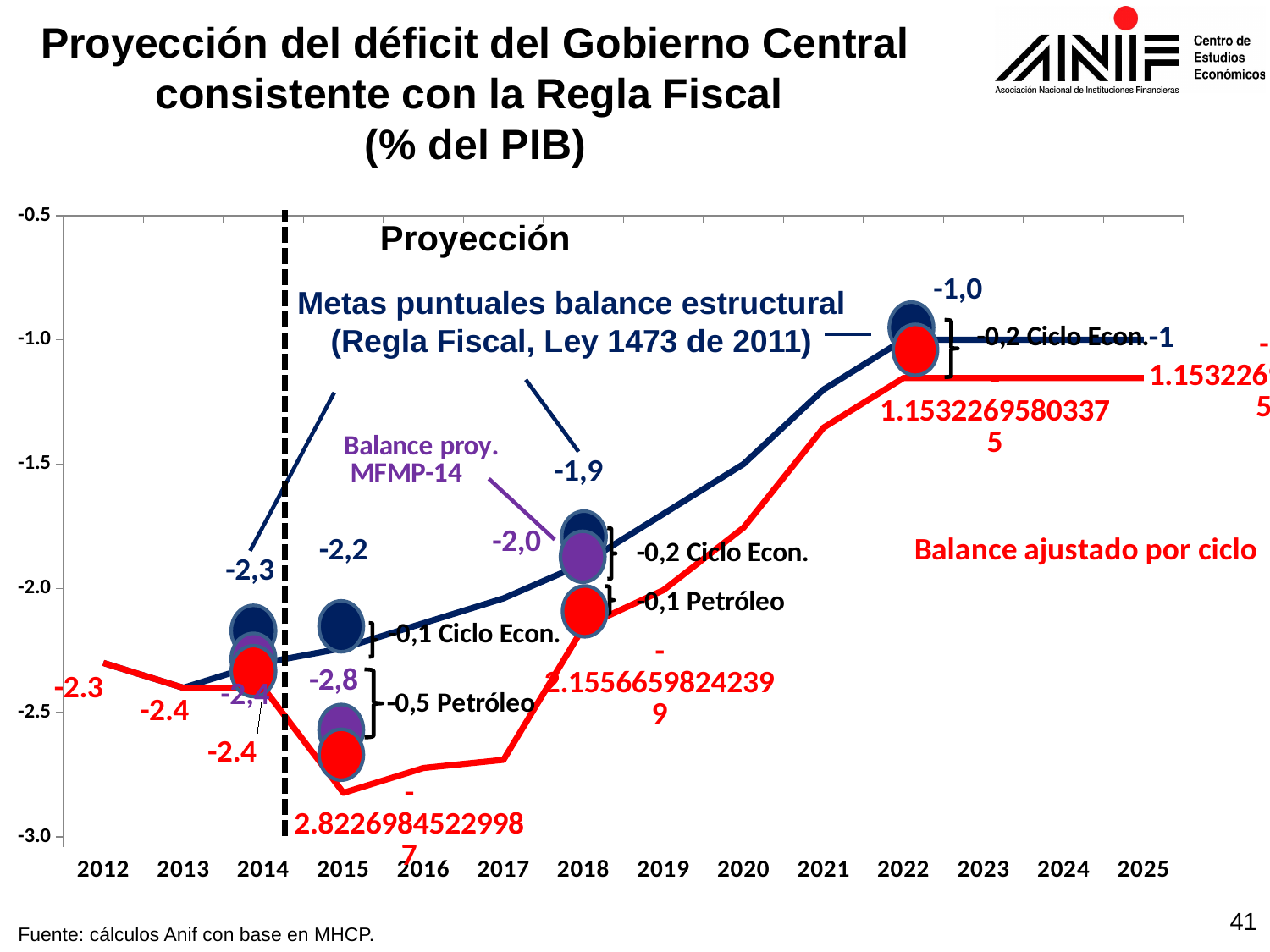
What is the value of the dark blue line (Metas puntuales balance estructural) for 2014? -2,3 Does the red line (Balance ajustado por ciclo) rise or fall between 2015 and 2022? rise What kind of chart is shown on the slide? line chart For 2015, which is larger: the dark blue line value or the red line value? the dark blue line value What is the value of the red line (Balance ajustado por ciclo) for 2013? -2.4 What is the difference between the dark blue line values for 2018 (-1,9) and 2014 (-2,3)? 0,4 What is the value of the purple Balance proy. MFMP-14 point for 2015? -2,8 Is the value of the red line for 2016 greater or less than -2.5? less In which year does the red line (Balance ajustado por ciclo) reach its lowest value? 2015 What is the value of the dark blue line (Metas puntuales balance estructural) for 2018? -1,9 What is the value of the dark blue line (Metas puntuales balance estructural) for 2022? -1,0 How many years are shown on the x axis? 14